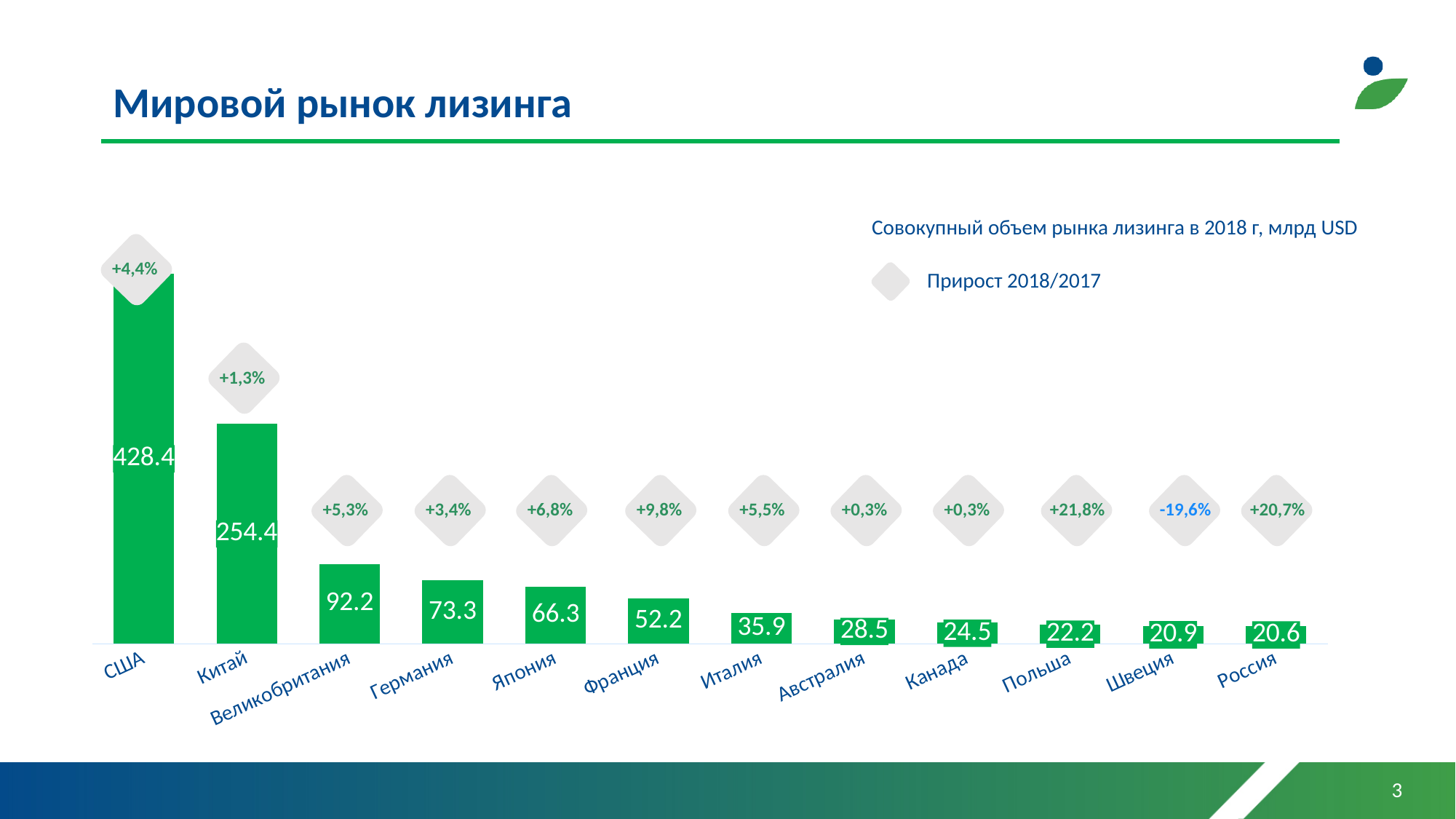
How many countries are shown in the chart? 12 Do the values rise or fall from left to right along the x axis? fall Which has a larger value, Япония or Франция? Япония Which country has the lowest value in the chart? Россия What is the difference between the values for США and Китай? 174 What is the value for Германия (Germany) in the chart? 73.3 Which country has the highest value in the chart? США What kind of chart is shown on the slide? bar chart What is the value for США (USA) in the chart? 428.4 What is the value for Россия (Russia) in the chart? 20.6 Which country is the only one with a negative growth rate (Прирост 2018/2017)? Швеция What growth rate (Прирост 2018/2017) is shown for Польша (Poland)? +21,8%